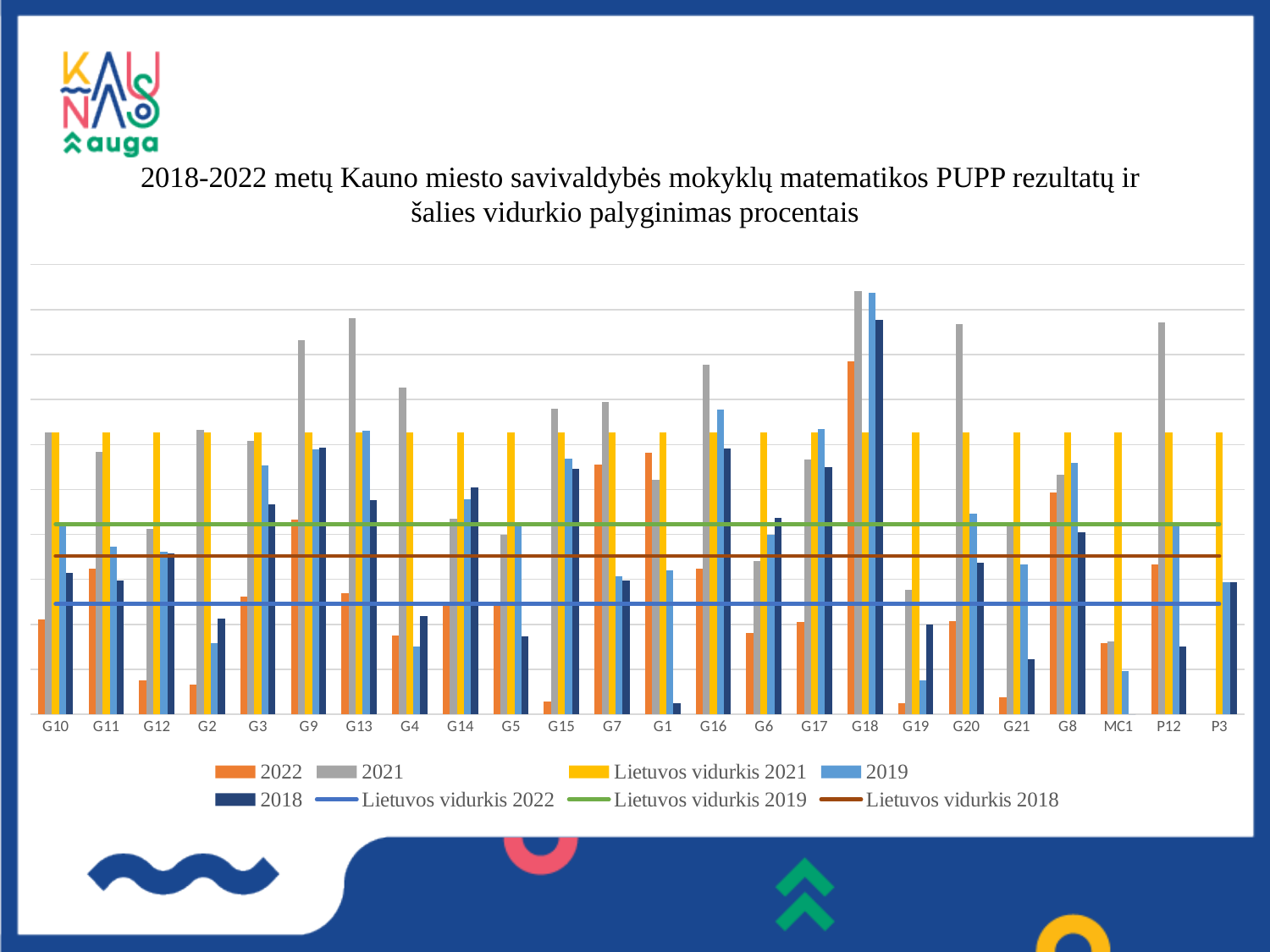
For the 2022 series, which is larger: the value for G7 or the value for G12? G7 For the 2021 series, which is larger: the value for G18 or the value for G10? G18 Which series is shown in orange in the chart's legend? 2022 How many series does the chart's legend list? 8 Which school has the highest value for the 2021 series? G18 Which school has the highest value for the 2019 series? G18 Which school has the highest value for the 2018 series? G18 How many school categories are shown along the x axis of the chart? 24 What kind of chart is shown on the slide? combination bar and line chart What is the title of the chart? 2018-2022 metų Kauno miesto savivaldybės mokyklų matematikos PUPP rezultatų ir šalies vidurkio palyginimas procentais Which school has the lowest value for the 2021 series? MC1